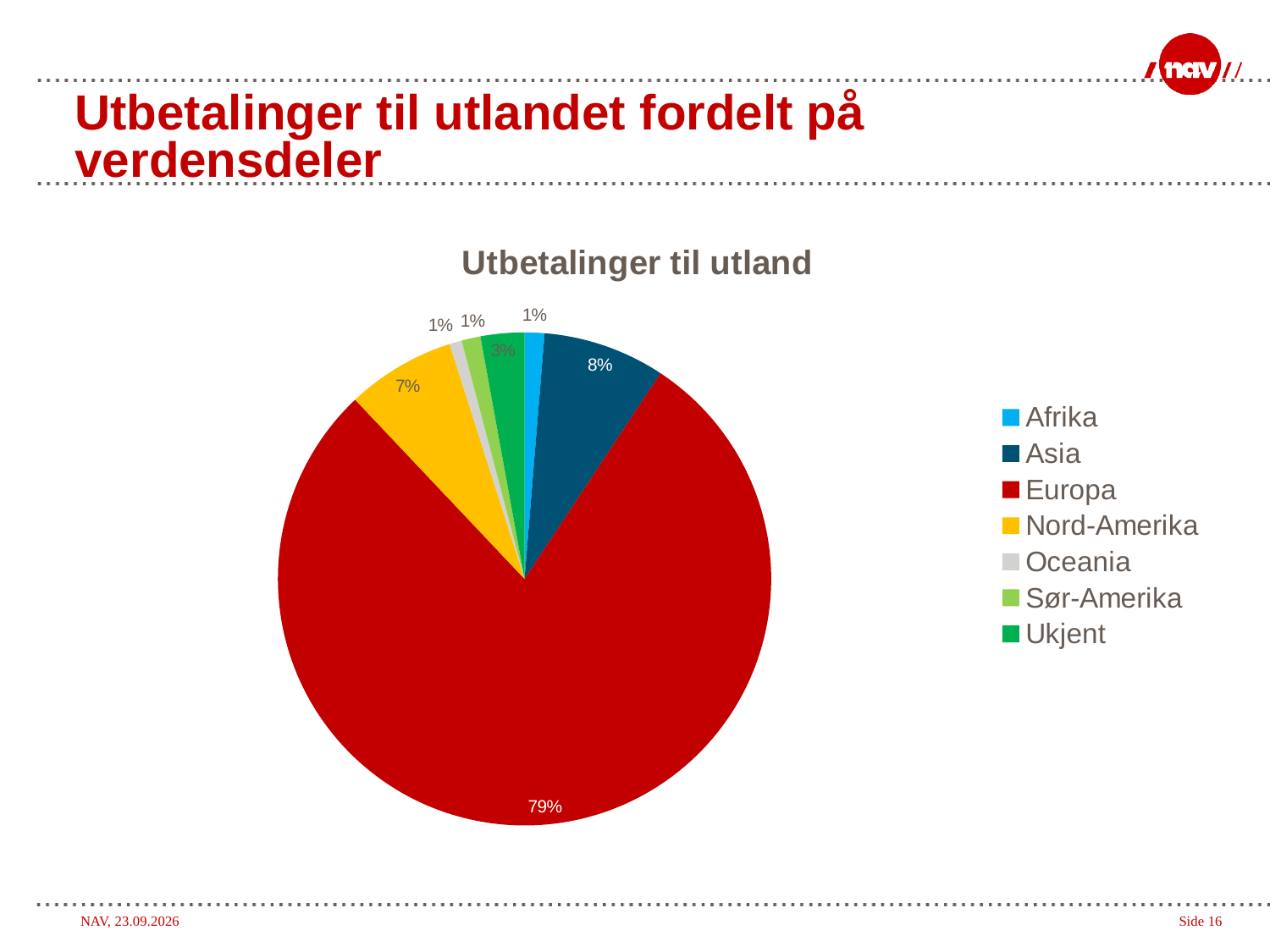
Which category has the largest slice of the pie? Europa What kind of chart is shown on the slide? pie chart What is the title of the chart? Utbetalinger til utland How many categories does the legend of the pie chart list? 7 What share of the pie does Asia have? 8% What share of the pie does Ukjent have? 3% What share of the pie does Nord-Amerika have? 7% What is the difference in percentage points between the Nord-Amerika slice and the Ukjent slice? 4 Which is larger, the slice for Asia or the slice for Nord-Amerika? Asia What is the difference in percentage points between the Europa slice and the Asia slice? 71 Which colour represents Europa in the pie chart? red